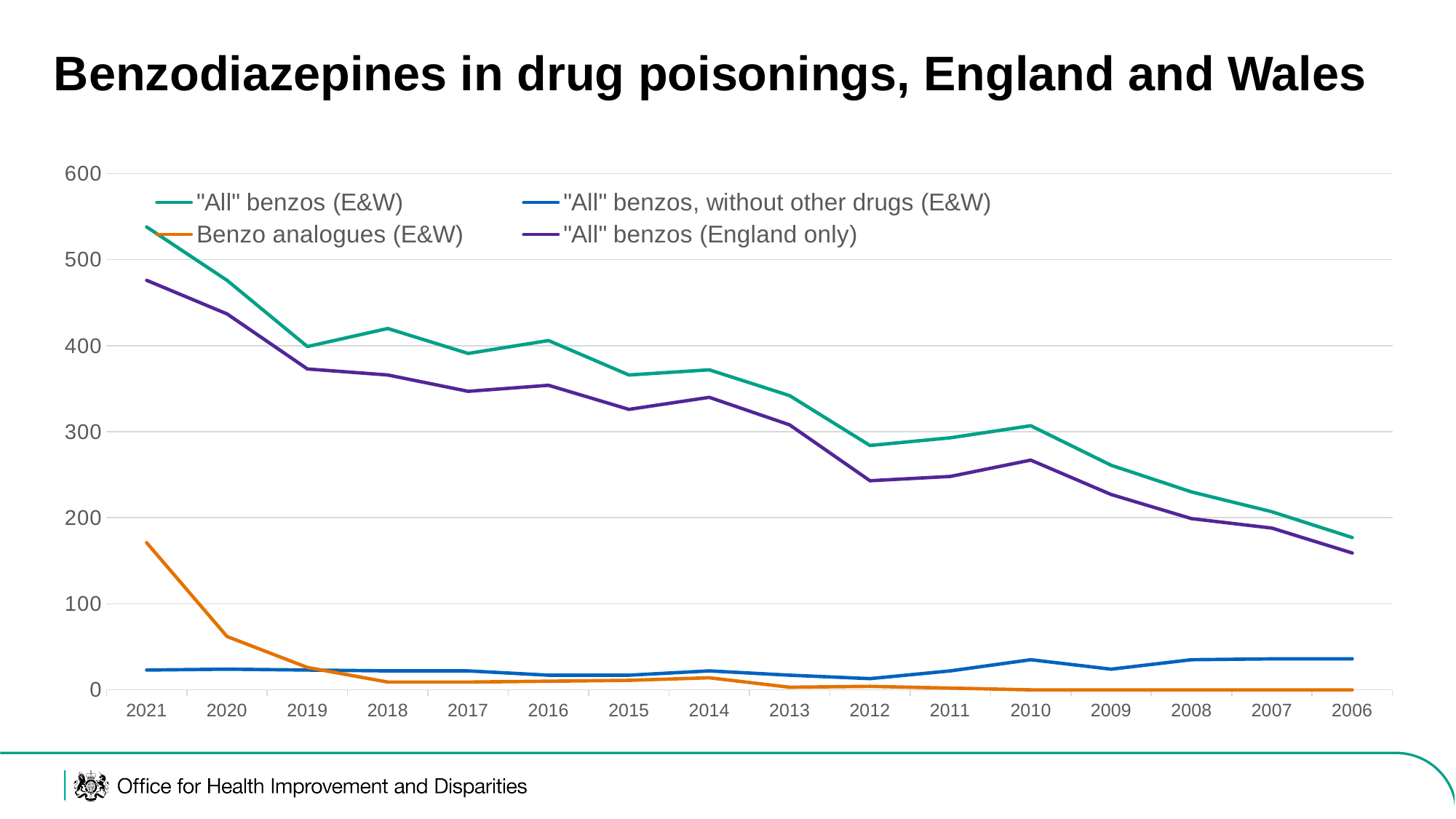
How many years are shown along the x axis? 16 What is the title of the chart? Benzodiazepines in drug poisonings, England and Wales Is the value for "All" benzos (E&W) in 2006 greater or less than 200? less What kind of chart is shown on the slide? Line chart In which year is the value for Benzo analogues (E&W) highest? 2021 In which year is the value for "All" benzos (E&W) highest? 2021 In 2021, which is larger: "All" benzos (E&W) or "All" benzos (England only)? "All" benzos (E&W) Is the value for "All" benzos (England only) in 2021 greater or less than 500? less In which year is the value for "All" benzos (E&W) lowest? 2006 Is the value for "All" benzos (E&W) in 2021 greater or less than 500? greater How many series does the legend list? 4 Which series is drawn in orange? Benzo analogues (E&W)